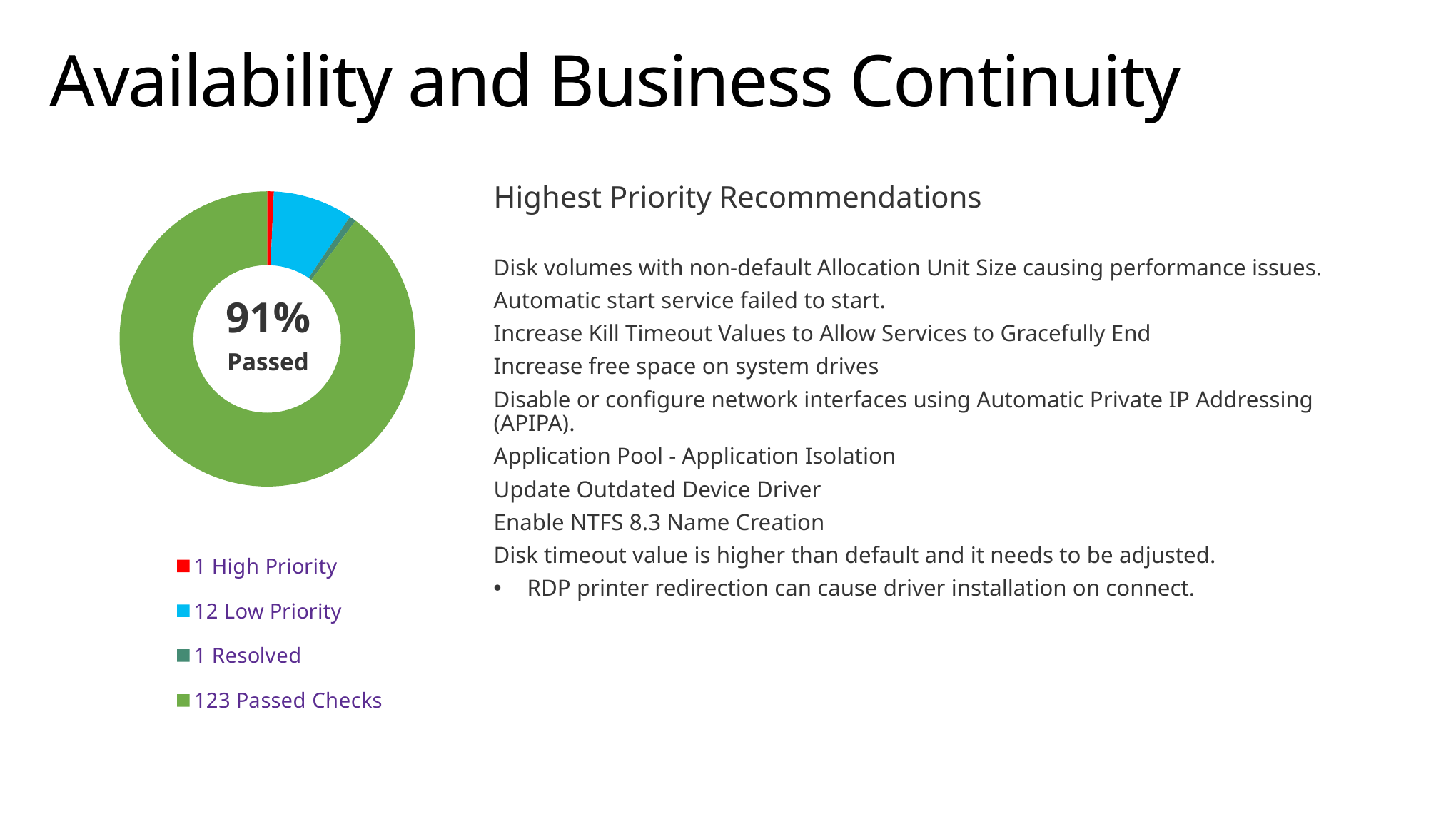
What is the total of all four categories in the chart? 137 Which is larger, Low Priority or High Priority? Low Priority How many categories does the chart's legend list? 4 What percentage is displayed in the centre of the donut chart? 91% What colour represents Passed Checks in the chart? green What is the difference between Passed Checks and Low Priority? 111 How many Passed Checks does the chart show? 123 How many Low Priority items does the chart show? 12 How many High Priority items does the chart show? 1 What kind of chart is shown on the slide? donut (pie) chart Which category has the largest value in the chart? Passed Checks How many categories in the legend have a value of 1? 2